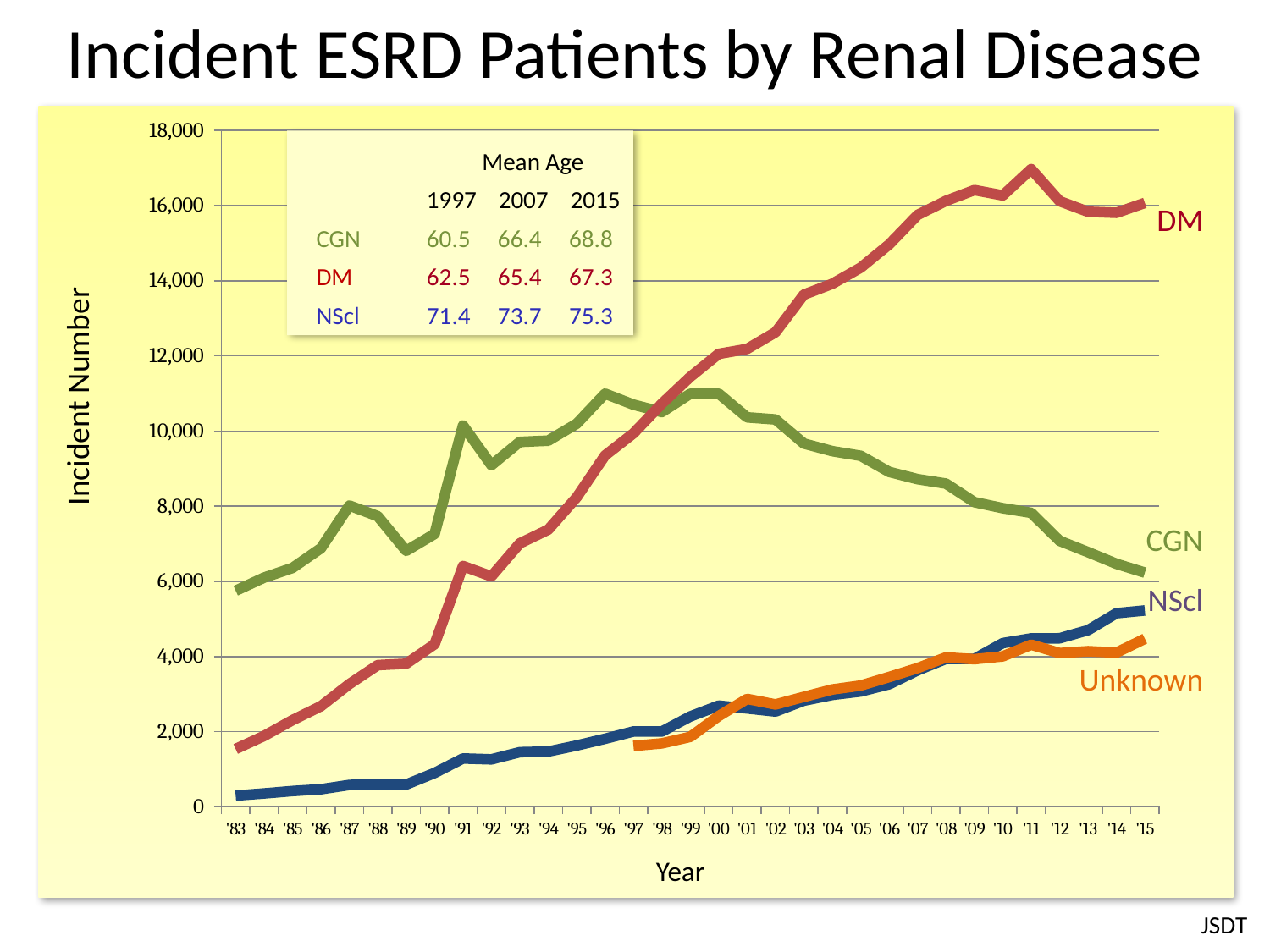
Does the incident number for CGN rise or fall from '00 to '15? fall Is the incident number for DM in '15 greater or less than 14,000? greater How many years are shown along the x axis, from '83 to '15? 33 According to the inset table, what is the mean age for NScl in 2015? 75.3 Is the incident number for CGN in '15 greater or less than 8,000? less Does the incident number for DM generally rise or fall from '83 to '15? rise Is the incident number for NScl in '15 greater or less than 4,000? greater Which series has the highest incident number in '15? DM In '90, which is larger, the incident number for CGN or for DM? CGN What kind of chart is shown on the slide? line chart How many disease series are plotted on the chart? 4 Which series has the lowest incident number in '15? Unknown